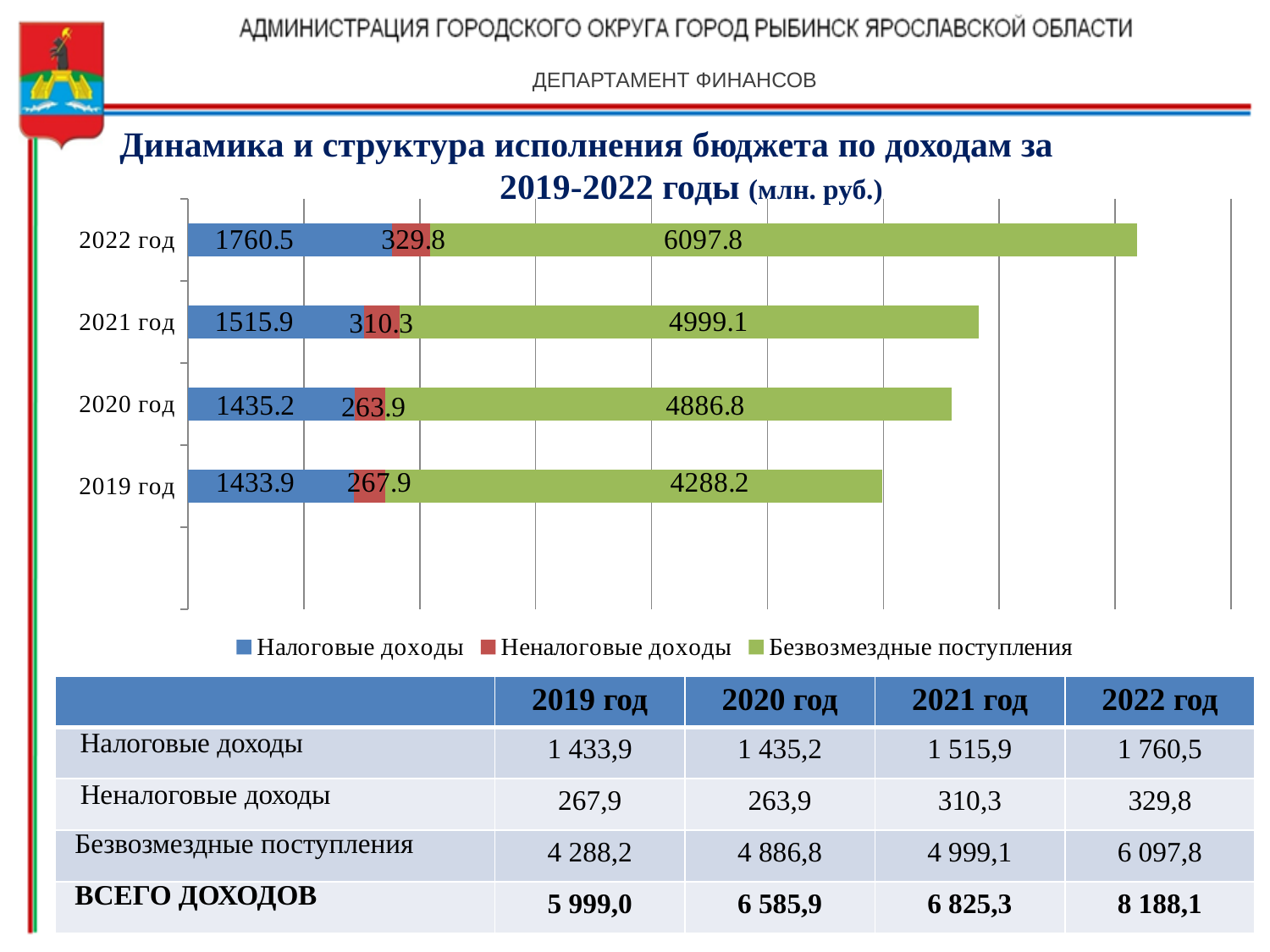
Which year has the lowest value of Неналоговые доходы? 2020 год Which year has the highest value of Безвозмездные поступления? 2022 год How many years are shown on the chart? 4 Which colour represents Неналоговые доходы in the chart? Red How many series does the legend list? 3 Is Безвозмездные поступления larger in 2021 год or in 2020 год? 2021 год What is the difference between Налоговые доходы in 2022 год and 2021 год? 244.6 What is the value of Безвозмездные поступления for 2019 год? 4288.2 What is the value of Неналоговые доходы for 2021 год? 310.3 What kind of chart is shown on the slide? Stacked bar chart What is the total of the stacked bar for 2022 год? 8188.1 What is the value of Налоговые доходы for 2022 год? 1760.5